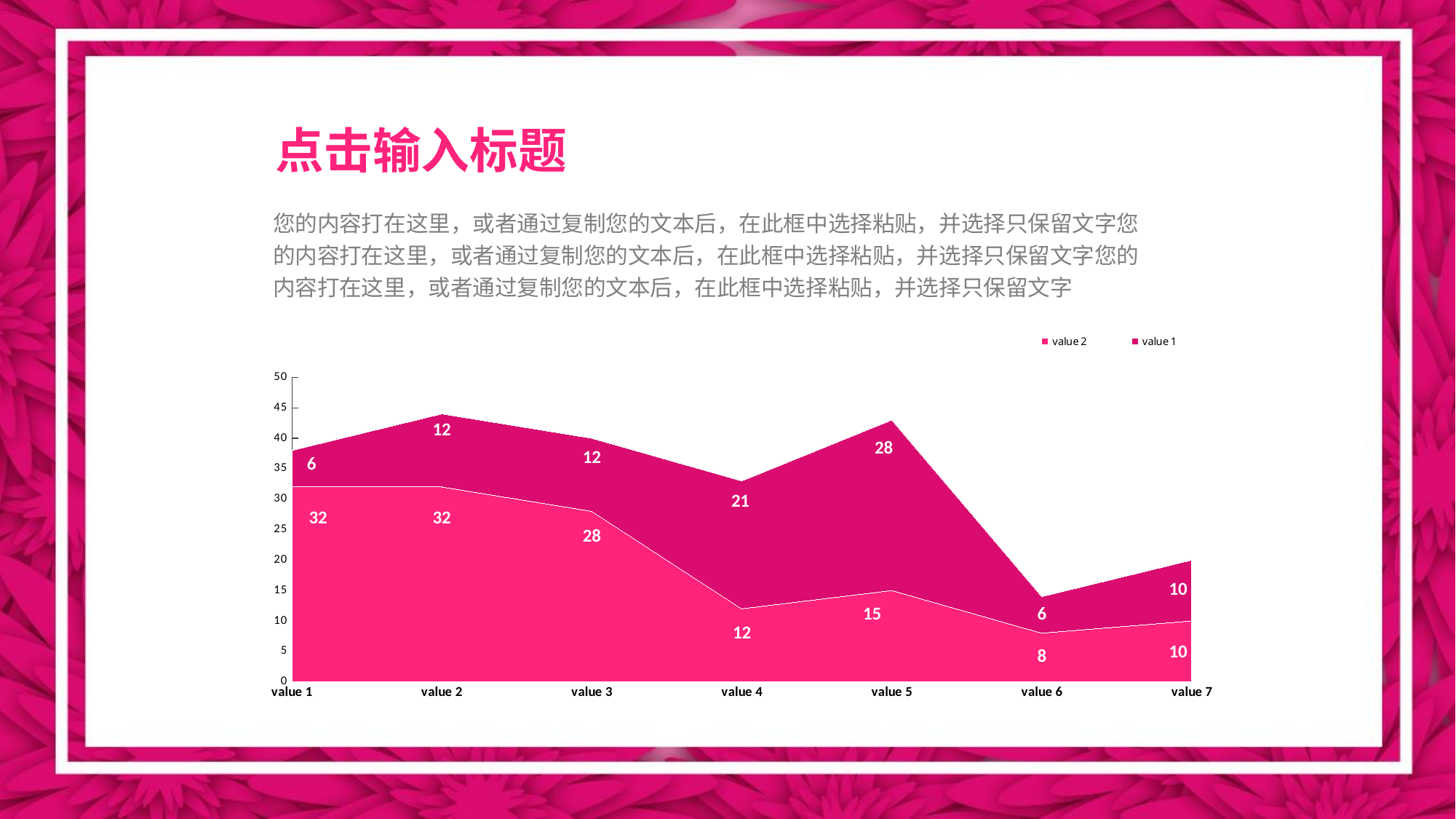
At which category is the "value 2" series lowest? value 6 At which category does the "value 1" series reach its highest value? value 5 How many series does the legend list? 2 What is the value of the "value 2" series at category "value 1"? 32 At category "value 3", which series has the larger value, "value 1" or "value 2"? value 2 What is the value of the "value 1" series at category "value 5"? 28 Does the "value 2" series rise or fall from "value 1" to "value 4"? Fall What kind of chart is shown on the slide? Area chart What is the combined total of both series at category "value 2"? 44 What is the value of the "value 2" series at category "value 6"? 8 How many categories are shown on the x axis? 7 What is the difference between the "value 1" series at "value 5" and at "value 1"? 22